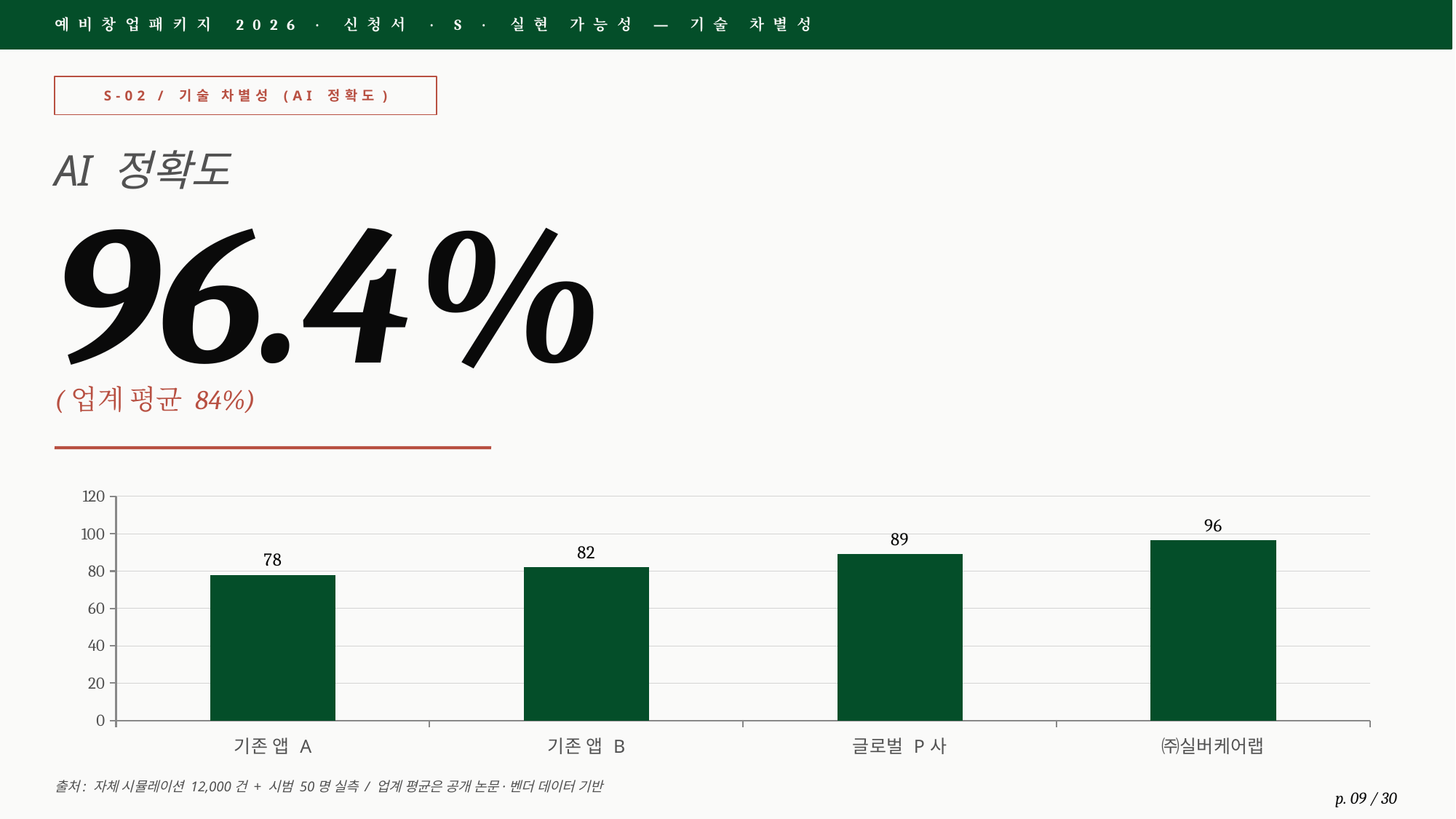
What is the value for 기존 앱 A? 78 What kind of chart is shown on the slide? bar chart Which category has the lowest value? 기존 앱 A How many categories are shown on the x axis? 4 What is the value for 기존 앱 B? 82 What is the difference between the values for 글로벌 P 사 and 기존 앱 B? 7 Which category has the highest value? ㈜실버케어랩 Which is larger, the value for 글로벌 P 사 or the value for 기존 앱 B? 글로벌 P 사 What is the value for ㈜실버케어랩? 96 What is the difference between the values for ㈜실버케어랩 and 기존 앱 A? 18 What is the value for 글로벌 P 사? 89 Is the value for 기존 앱 A greater or less than 80? less